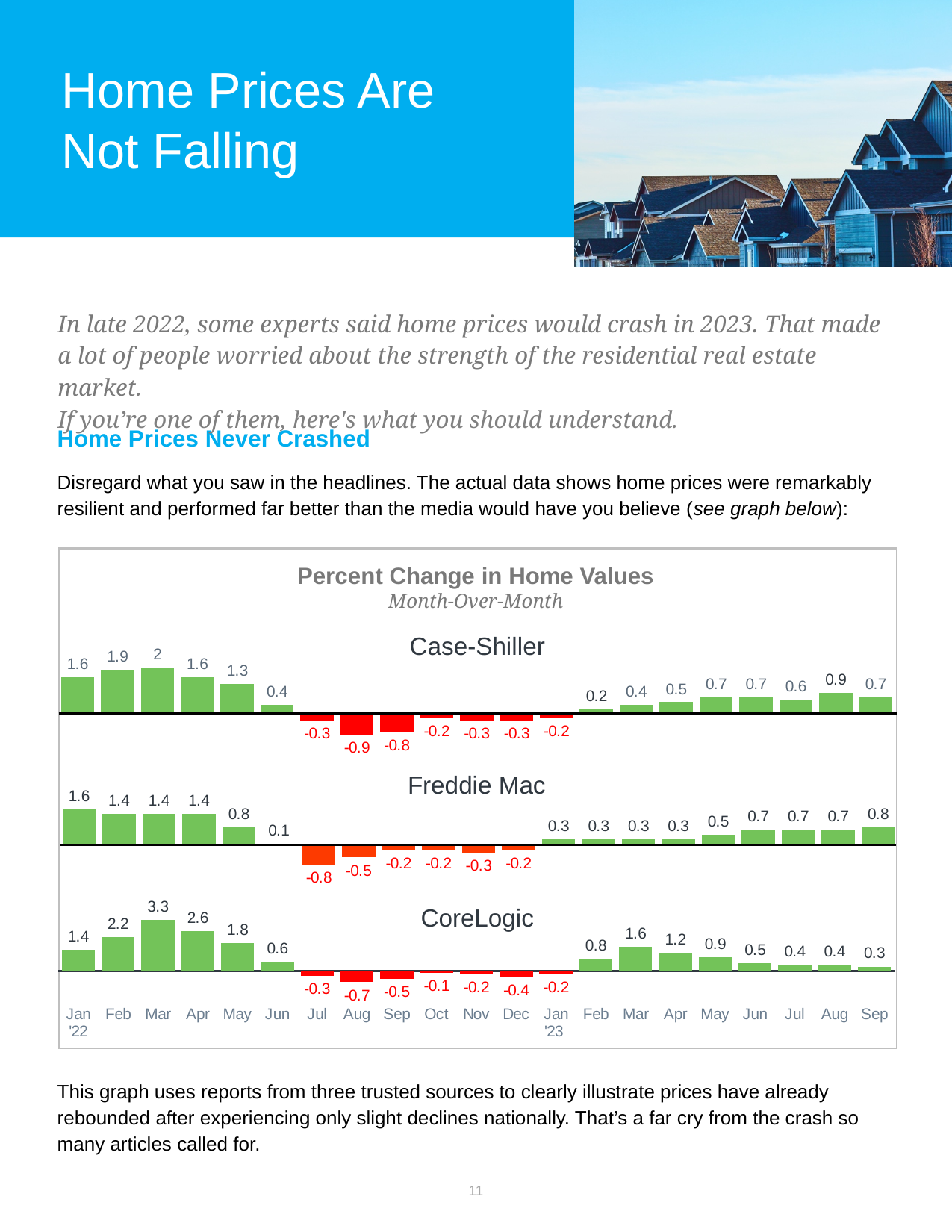
In the CoreLogic chart, what is the difference between the Feb '22 value and the Feb '23 value? 1.4 In the Case-Shiller chart, what is the percent change for Aug '22? -0.9 In the CoreLogic chart, which month has the highest value? Mar '22 In the Freddie Mac chart, what is the value for Jun '22? 0.1 In the Freddie Mac chart, which is larger: the value for Jan '22 or the value for Sep '23? Jan '22 In the CoreLogic chart, what is the value for Mar '23? 1.6 What type of chart is used for the Freddie Mac data? Bar chart In the Case-Shiller chart, what is the difference between the Mar '22 value and the Sep '23 value? 1.3 In the Freddie Mac chart, which month has the lowest value? Jul '22 What is the title of the graph containing the three charts? Percent Change in Home Values Month-Over-Month In the Case-Shiller chart, do the values rise or fall from Jan '23 to Apr '23? Rise How many months are plotted in the CoreLogic chart? 21